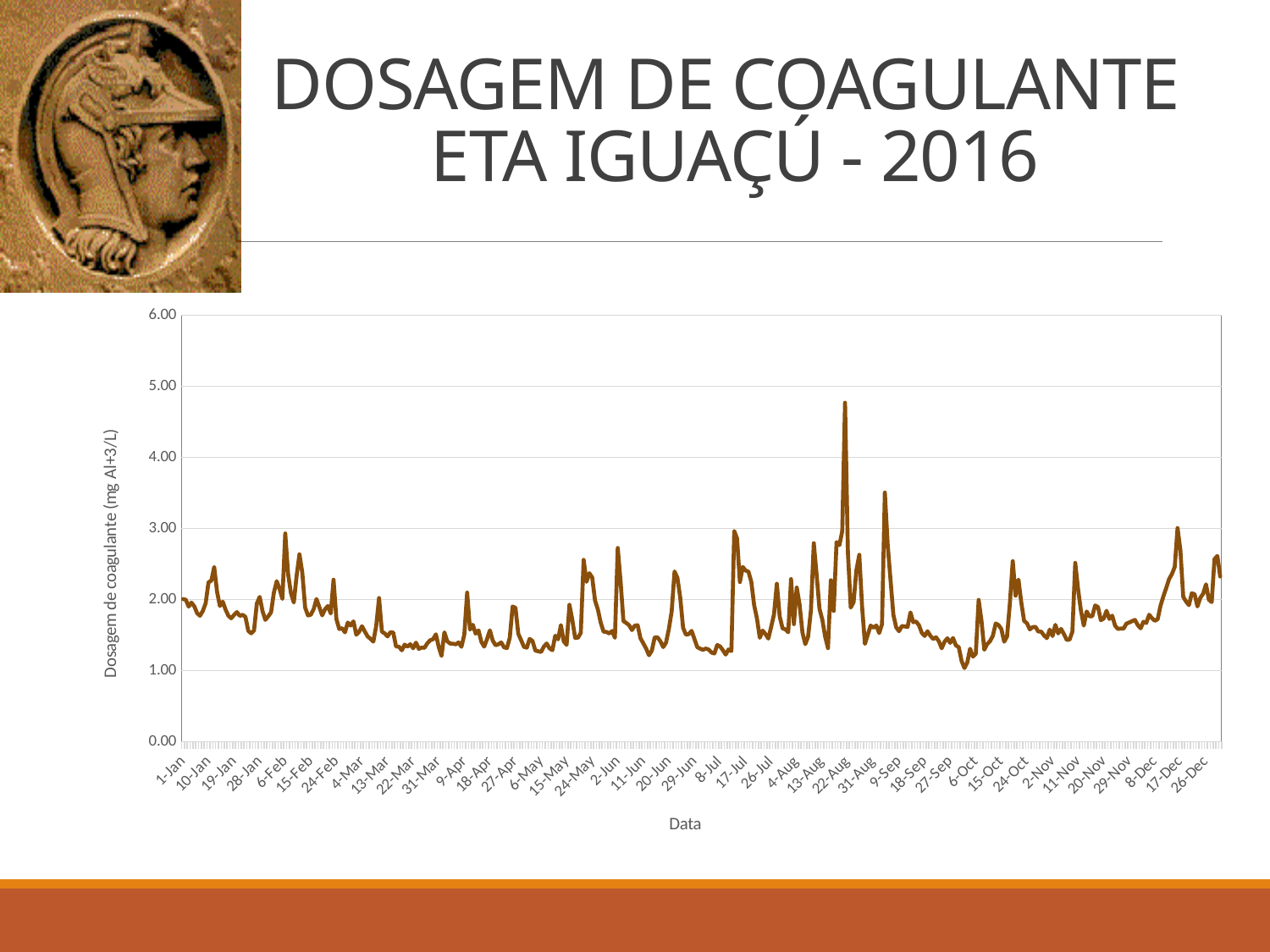
What is the label of the vertical axis? Dosagem de coagulante (mg Al+3/L) Is the highest value plotted on the chart greater or less than 4.00? greater Is the value plotted at 22-Mar greater or less than 2.00? less What kind of chart is shown on the slide? line chart Is the peak value near 9-Sep greater or less than 3.00? greater Does the plotted value overall rise or fall between 1-Jan and 22-Mar? fall What is the title of the chart on the slide? DOSAGEM DE COAGULANTE ETA IGUAÇÚ - 2016 Is the peak value near 22-Aug larger or smaller than the peak value near 9-Sep? larger What is the maximum value shown on the vertical axis? 6.00